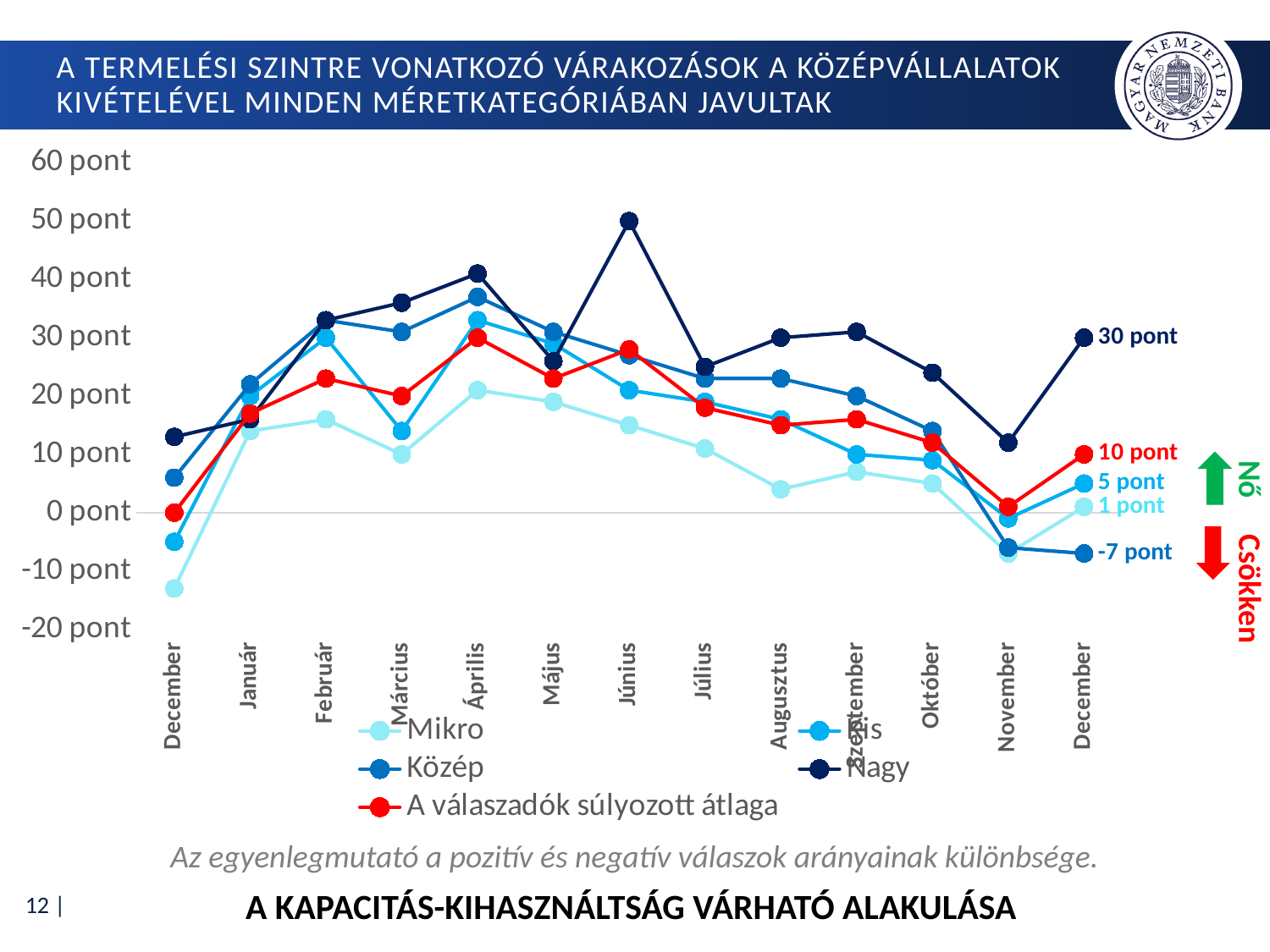
Does the Nagy series rise or fall from November to the final December? rise What is the value of the Kis series at the final December point? 5 pont What is the value of the Nagy series at the final December point? 30 pont What kind of chart is shown on the slide? line chart Which series has the highest value at the final December point? Nagy Is the value for Nagy in Június greater or less than 40 pont? greater At the final December point, which is larger: the Kis value or the Mikro value? Kis What is the value of the Közép series at the final December point? -7 pont What is the value of 'A válaszadók súlyozott átlaga' at the final December point? 10 pont What is the difference between the Nagy and Közép values at the final December point? 37 pont Which series has the lowest value at the final December point? Közép How many series does the legend list? 5